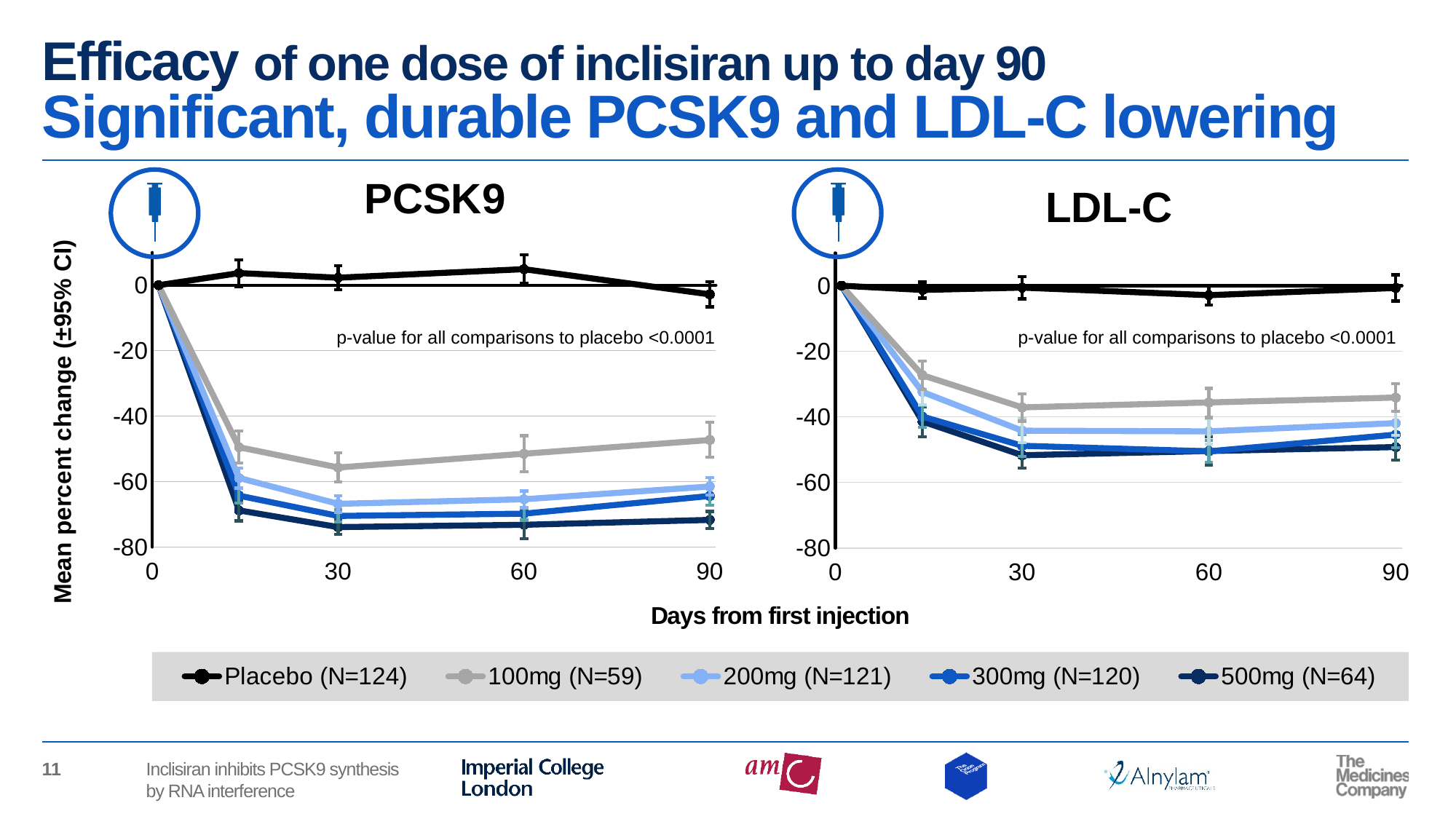
What kind of chart is the PCSK9 chart? line chart In the LDL-C chart, is the value for 500mg (N=64) at day 60 greater or less than -40? less In the PCSK9 chart, is the value for 100mg (N=59) at day 30 greater or less than -40? less In the LDL-C chart, which series has the highest value among the inclisiran doses at day 90? 100mg (N=59) What is the y-axis title of the charts? Mean percent change (±95% CI) How many series does the legend list? 5 What is the x-axis title shared by the two charts? Days from first injection In the PCSK9 chart, which series has the highest values across the time points? Placebo (N=124) In the LDL-C chart, is the value for 100mg (N=59) at day 30 greater or less than -40? greater In the PCSK9 chart, which series has the lowest value at day 30? 500mg (N=64) In the PCSK9 chart, which is larger at day 90: the value for 100mg (N=59) or the value for 500mg (N=64)? 100mg (N=59) In the PCSK9 chart, does the 100mg (N=59) line rise or fall between day 30 and day 90? rise